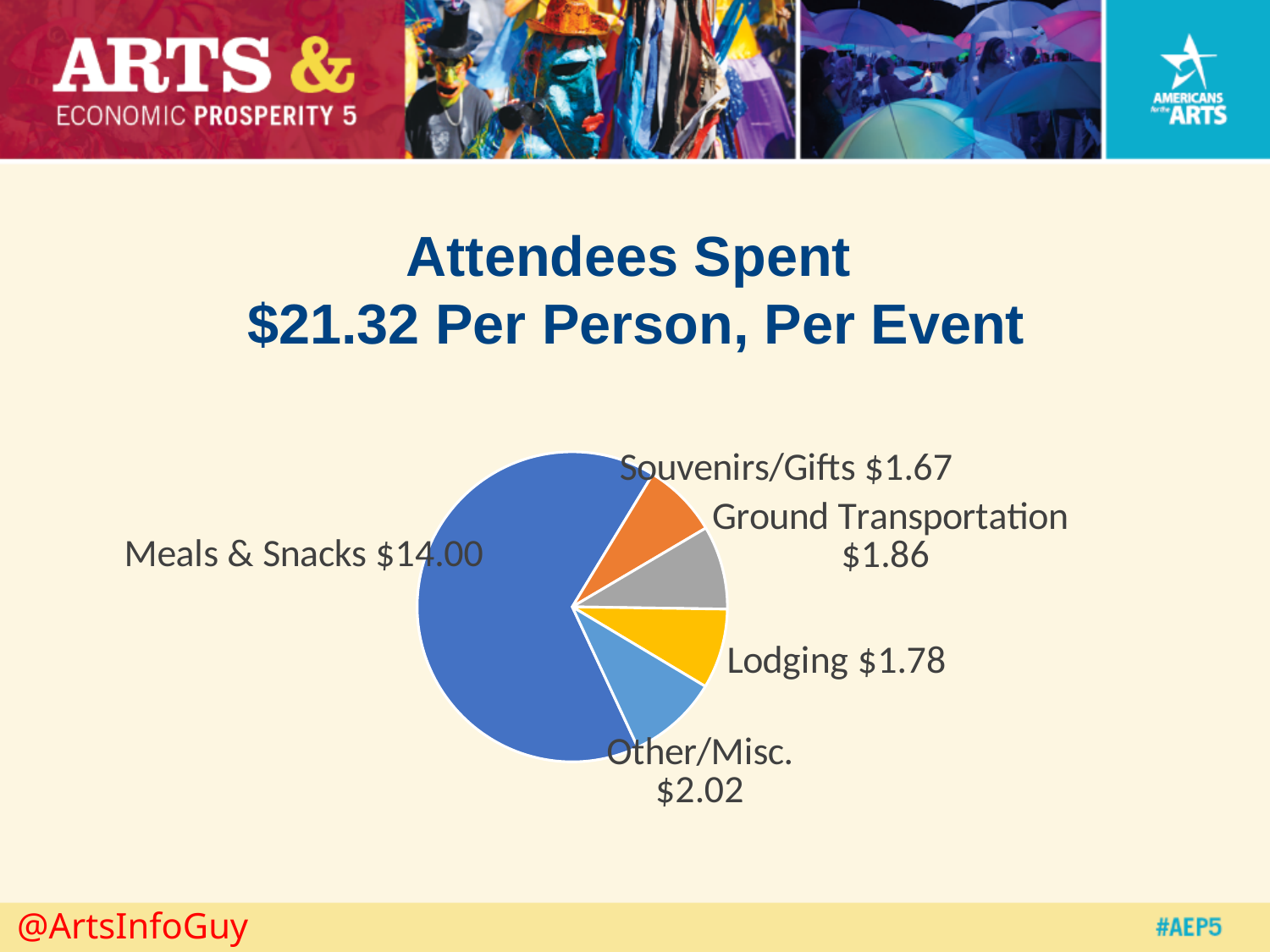
Which is larger, Ground Transportation or Lodging? Ground Transportation Which spending category has the largest slice of the pie? Meals & Snacks What is the value shown for Ground Transportation? $1.86 What is the difference between Meals & Snacks and Other/Misc. spending? $11.98 What is the value shown for Souvenirs/Gifts? $1.67 How much did attendees spend on Meals & Snacks per person, per event? $14.00 What is the value shown for Lodging? $1.78 What is the title of the slide above the chart? Attendees Spent $21.32 Per Person, Per Event How many spending categories are shown in the pie chart? 5 What kind of chart is shown on the slide? Pie chart Which spending category has the smallest value? Souvenirs/Gifts How much more was spent on Other/Misc. than on Lodging? $0.24